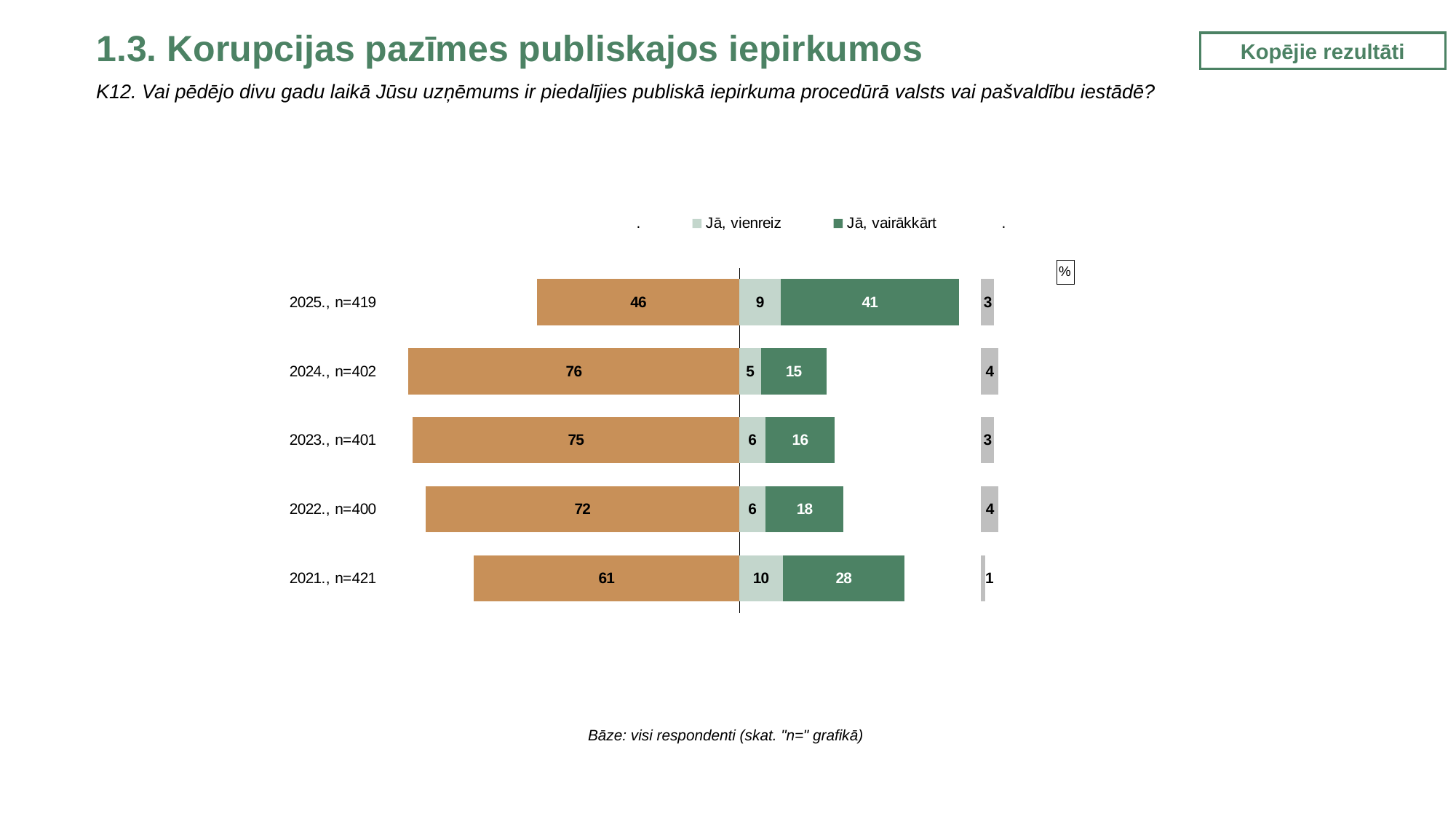
What are the two series names listed in the legend? Jā, vienreiz; Jā, vairākkārt How many years (categories) are shown in the chart? 5 How many series does the legend list? 2 What kind of chart is shown on the slide? Bar chart What is the difference between the "Jā, vairākkārt" values for 2025., n=419 and 2024., n=402? 26 What is the value for "Jā, vairākkārt" in 2025., n=419? 41 What is the value of the orange bar segment for 2024., n=402? 76 Which year has the larger "Jā, vairākkārt" value, 2022., n=400 or 2023., n=401? 2022., n=400 Which year has the highest value for "Jā, vairākkārt"? 2025., n=419 What is the combined total of "Jā, vienreiz" and "Jā, vairākkārt" for 2025., n=419? 50 Which year has the lowest value for "Jā, vienreiz"? 2024., n=402 What is the value for "Jā, vienreiz" in 2021., n=421? 10